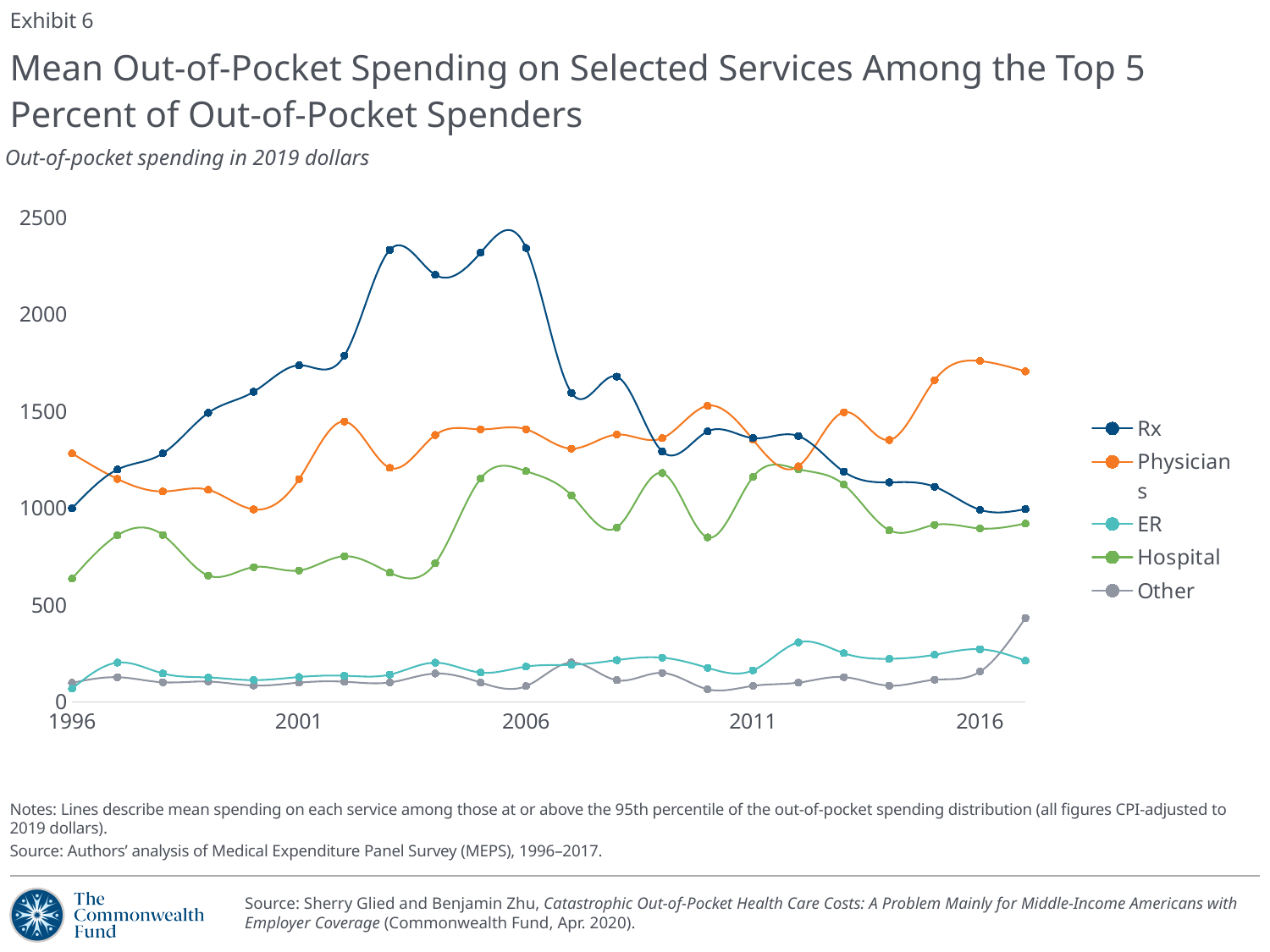
Which series has the highest value in 2017? Physicians Is the value for Physicians in 2016 greater or less than 1500? greater Does the Rx line rise or fall between 2005 and 2017? fall Is the value for Hospital in 1996 greater or less than 1000? less Which series has the lowest value in 2005? Other What kind of chart is shown on the slide? line chart What is the title of the chart? Mean Out-of-Pocket Spending on Selected Services Among the Top 5 Percent of Out-of-Pocket Spenders In 2016, which is larger: the value for Rx or the value for Physicians? Physicians Is the value for ER in 2012 greater or less than 500? less Which series has the highest value in 2005? Rx How many series does the legend list? 5